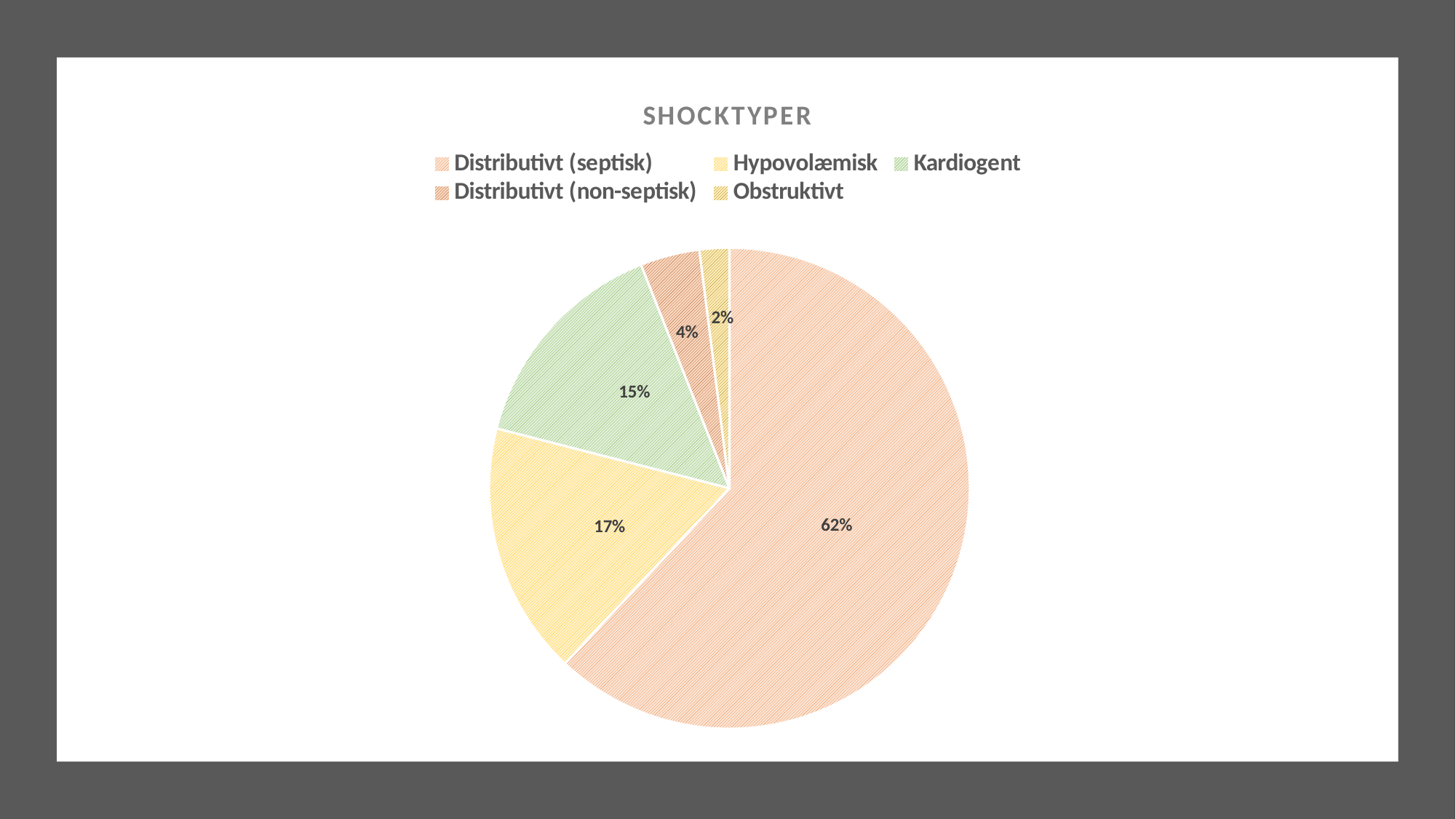
What type of chart is shown on the slide? pie chart What share of the pie does Kardiogent take? 15% Which is larger, the slice for Kardiogent or the slice for Distributivt (non-septisk)? Kardiogent How many slices does the pie chart have? 5 Which shock type has the largest slice? Distributivt (septisk) What share of the pie does Obstruktivt take? 2% Which shock type has the smallest slice? Obstruktivt What is the difference in percentage points between Hypovolæmisk and Kardiogent? 2% What share of the pie does Distributivt (non-septisk) take? 4% What is the title of the chart? SHOCKTYPER